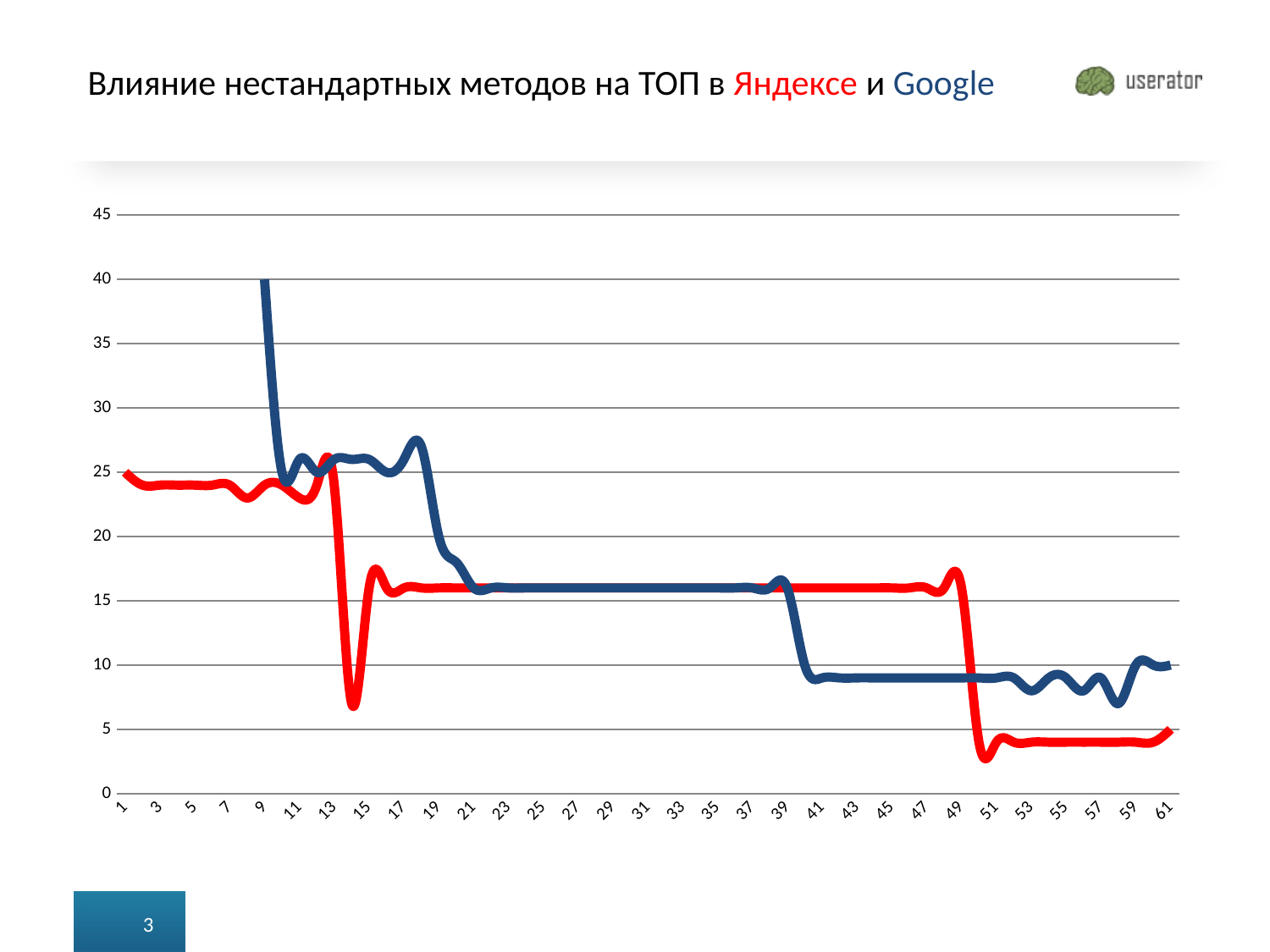
What is the highest value shown on the vertical axis? 45 Overall, do the values of the red line rise or fall from left to right along the x axis? fall Overall, do the values of the blue line rise or fall from left to right along the x axis? fall Is the value of the blue line at point 30 greater or less than 10? greater Is the value of the red line at point 51 greater or less than 5? less At point 55, which line has the higher value, the red line or the blue line? blue line How many lines (series) are plotted on the chart? 2 What kind of chart is shown on the slide? line chart Is the value of the red line at point 14 greater or less than 10? less What is the last label on the horizontal axis? 61 At point 45, which line has the higher value, the red line or the blue line? red line